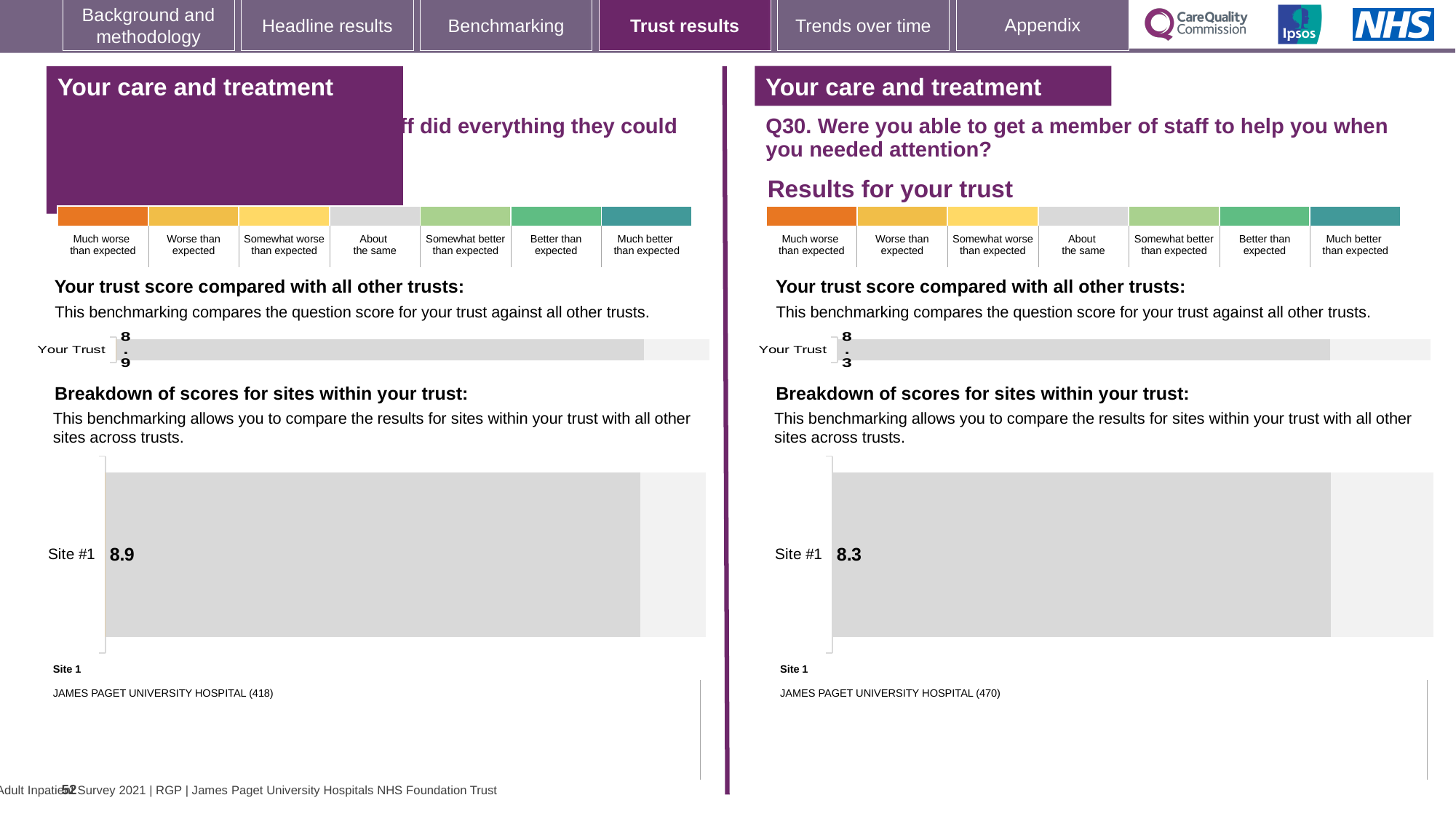
How many sites are shown in the right-hand breakdown of scores for sites within your trust? 1 On the right-hand breakdown of scores for sites (Q30), what is the score for Site #1? 8.3 On the right-hand chart for Q30, what is the score shown for Your Trust? 8.3 On the left-hand breakdown of scores for sites, what is the score for Site #1? 8.9 On the left-hand chart, what is the score shown for Your Trust? 8.9 On the right-hand side, which site name is listed as Site 1? JAMES PAGET UNIVERSITY HOSPITAL (470) On the left-hand side, what number appears in brackets after JAMES PAGET UNIVERSITY HOSPITAL under Site 1? 418 What type of chart is used to show the Site #1 score on the left-hand side of the slide? Bar chart What is the difference between the Site #1 score on the left-hand chart and the Site #1 score on the right-hand chart (Q30)? 0.6 Which is larger: the Your Trust score on the left-hand chart or the Your Trust score on the right-hand chart (Q30)? Left-hand chart (8.9)